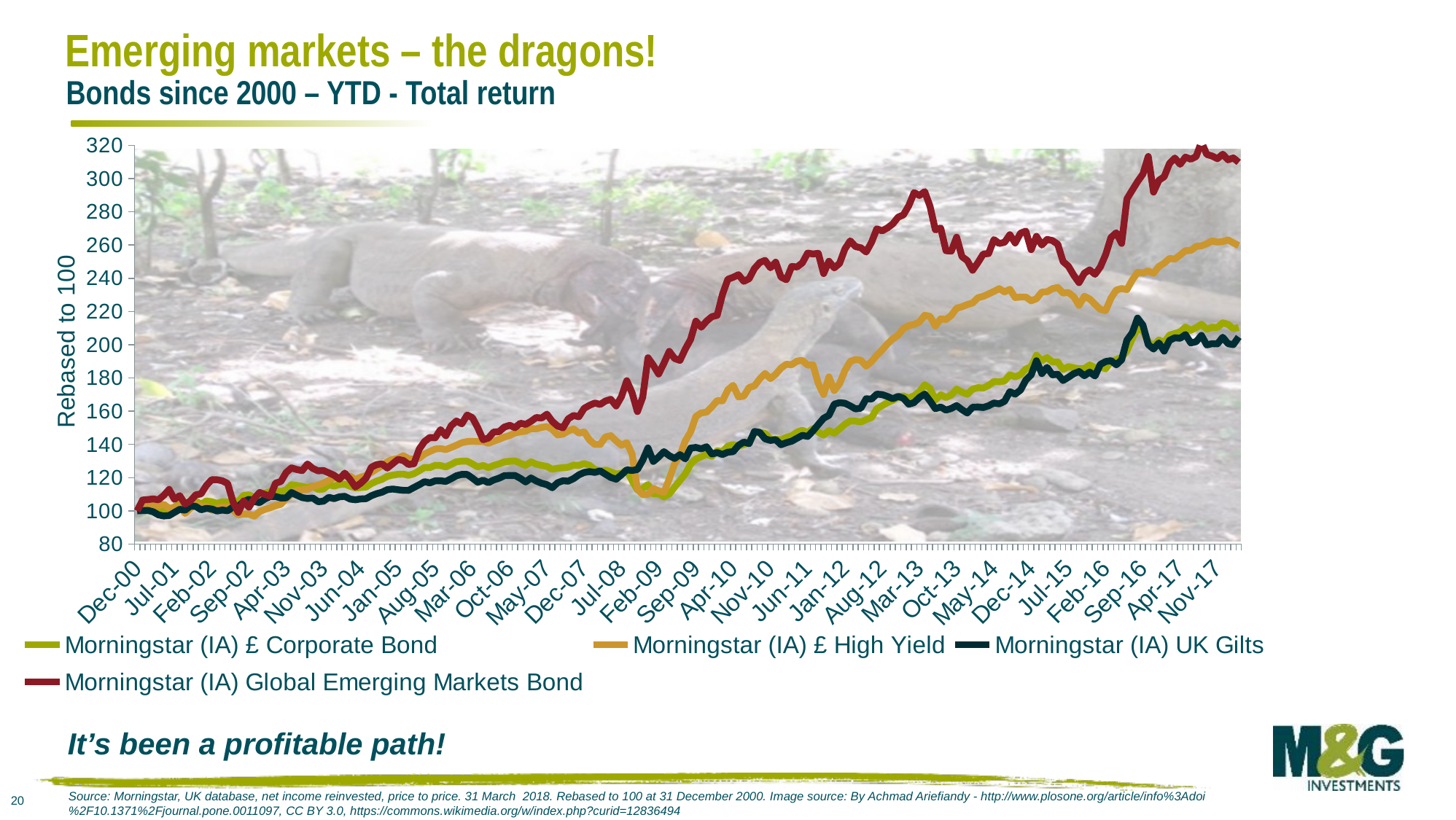
Is the value for Morningstar (IA) £ High Yield at the end of the chart greater or less than 240? greater Does the Morningstar (IA) Global Emerging Markets Bond line generally rise or fall from Dec-00 to Nov-17? Rise What kind of chart is shown on the slide? Line chart What is the first date label on the horizontal axis? Dec-00 Is the value for Morningstar (IA) UK Gilts at the end of the chart greater or less than 220? less What is the label on the vertical axis of the chart? Rebased to 100 What is the highest tick value shown on the vertical axis? 320 Is the value for Morningstar (IA) £ Corporate Bond at the end of the chart greater or less than 240? less Which series has the highest value at the right-hand end of the chart (Nov-17)? Morningstar (IA) Global Emerging Markets Bond How many series does the legend list? 4 At the end of the chart, which is larger: Morningstar (IA) £ High Yield or Morningstar (IA) UK Gilts? Morningstar (IA) £ High Yield